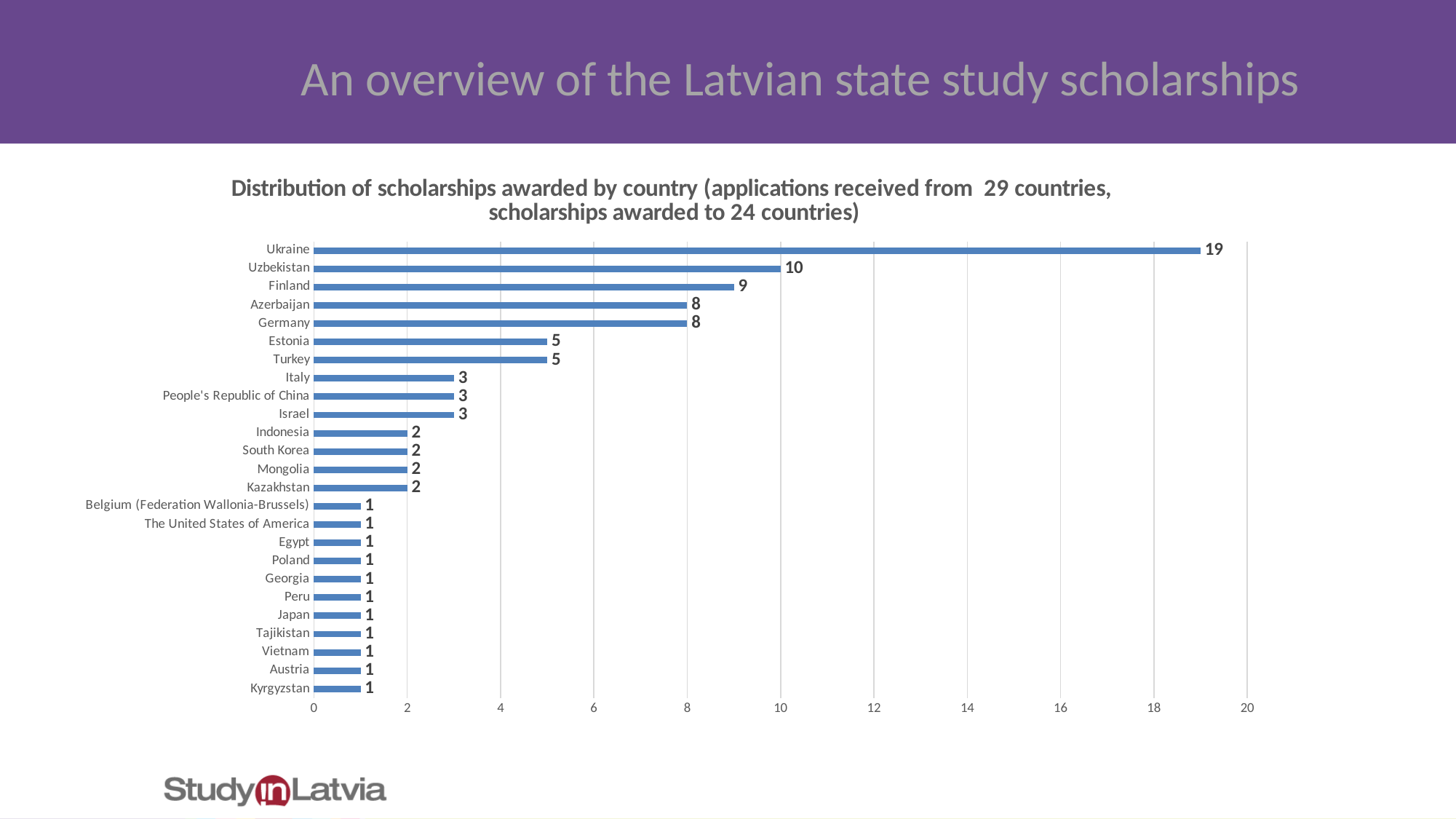
What is the value shown for Kazakhstan? 2 What is the value shown for Finland? 9 How many countries are listed on the chart? 25 How many scholarships were awarded to Ukraine? 19 What is the difference between the values for Finland and Germany? 1 What kind of chart is shown on the slide? Bar chart What is the difference between the values for Ukraine and Uzbekistan? 9 Is the value for Uzbekistan greater or less than 8? greater Which country received the most scholarships? Ukraine Which has a larger value, Azerbaijan or Turkey? Azerbaijan Which has a larger value, Italy or Indonesia? Italy How many scholarships were awarded to Estonia? 5